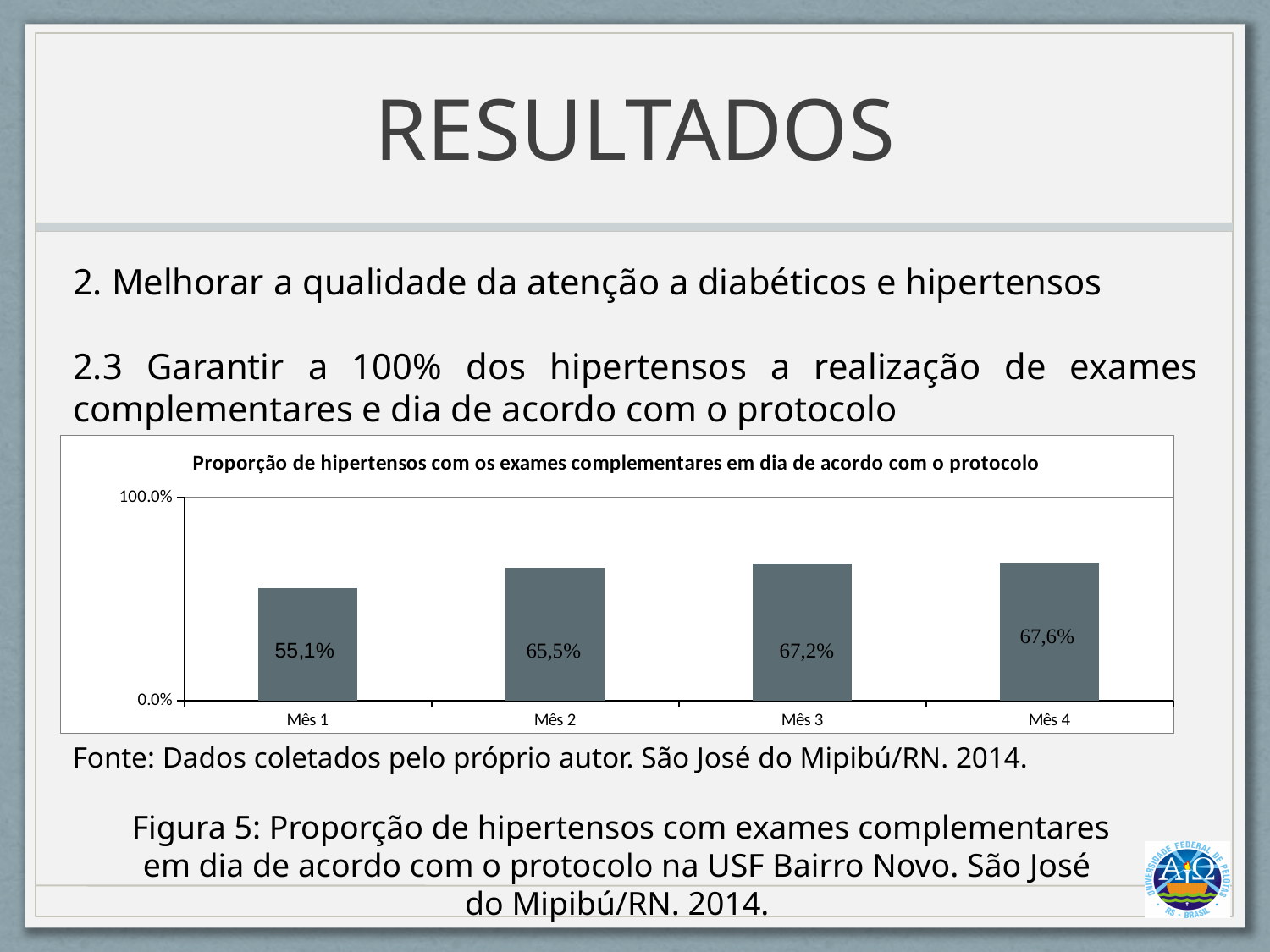
What is the highest value shown on the y axis? 100.0% What is the title of the chart? Proporção de hipertensos com os exames complementares em dia de acordo com o protocolo What is the value for Mês 1? 55,1% How many months are shown on the x axis? 4 Which month has the lowest proportion? Mês 1 What is the difference between the values for Mês 2 and Mês 1? 10,4% What kind of chart is this? Bar chart What is the value for Mês 3? 67,2% Which month has the highest proportion? Mês 4 Do the values rise or fall from Mês 1 to Mês 4? Rise Which is larger, the value for Mês 2 or the value for Mês 1? Mês 2 What is the value for Mês 4? 67,6%